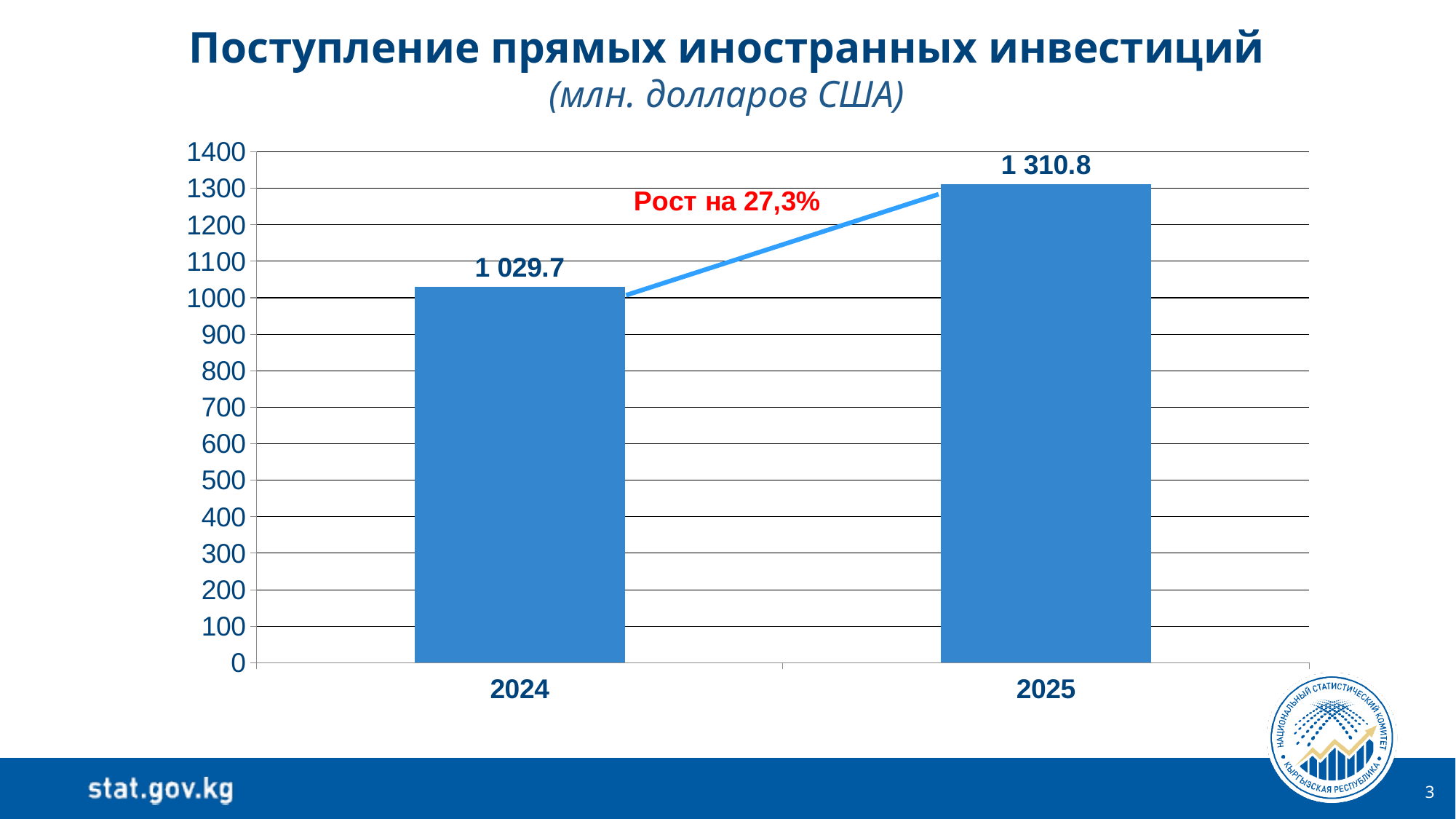
How many years are shown on the x axis? 2 What growth percentage is annotated on the chart? 27,3% Is the value for 2024 greater or less than 1000? greater Is the value for 2025 greater or less than 1400? less What kind of chart is shown on the slide? bar chart Do the values rise or fall from 2024 to 2025? rise What is the value for 2025? 1 310.8 Which year has the highest value? 2025 What is the difference between the values for 2025 and 2024? 281.1 Which is larger, the value for 2024 or the value for 2025? 2025 What is the value for 2024? 1 029.7 Which year has the lowest value? 2024